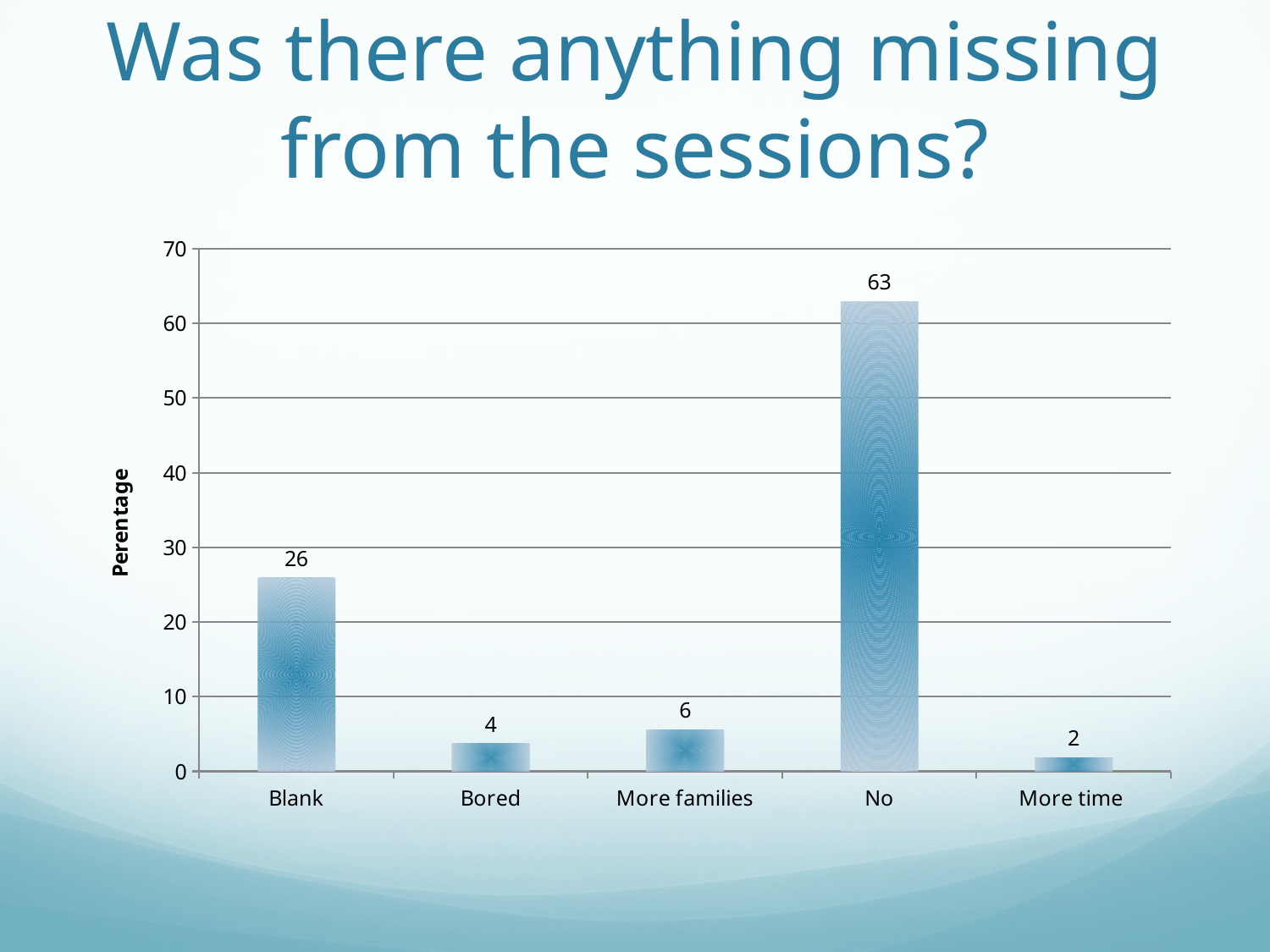
What is the value for "Bored"? 4 Which is larger, the value for "More families" or the value for "Bored"? More families Which category has the highest value? No Is the value for "No" greater or less than 60? greater What is the value for "No"? 63 What kind of chart is shown on the slide? bar chart What is the value for "Blank"? 26 Which category has the lowest value? More time What is the label of the vertical axis? Perentage How many categories are shown on the x axis? 5 What is the difference between the values for "No" and "Blank"? 37 What is the value for "More families"? 6